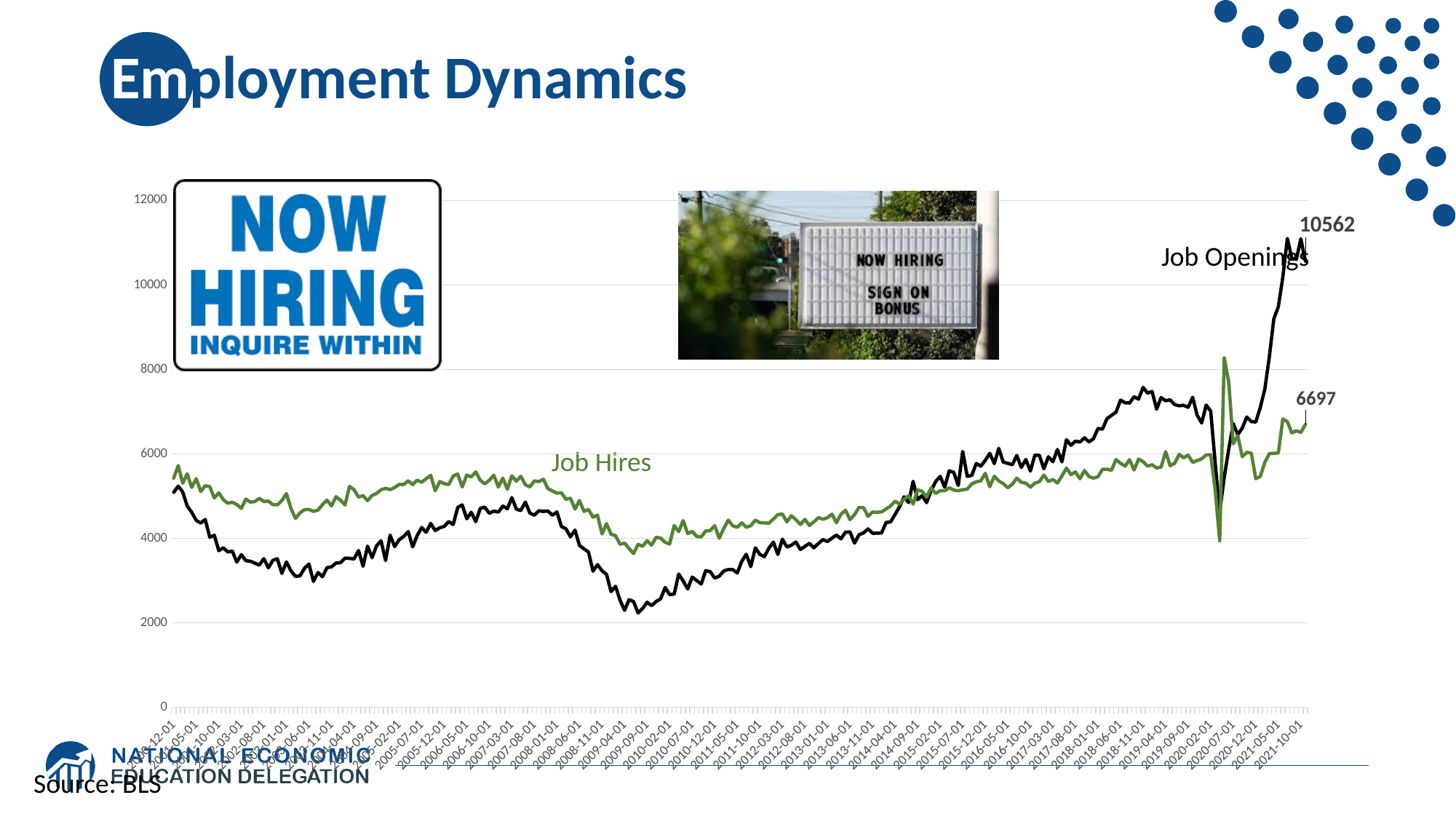
Is the value for Job Hires at 2000-12-01 greater or less than 4000? greater At the end of the chart, which series is larger, Job Openings or Job Hires? Job Openings How many series are plotted on the chart? 2 Does the Job Openings series generally rise or fall between 2009-09-01 and 2018-11-01? Rise What is the final labelled value of the Job Openings series? 10562 Which series reaches the highest value anywhere on the chart? Job Openings Is the value for Job Openings around 2009-09-01 greater or less than 4000? less What is the difference between the final labelled values of Job Openings and Job Hires? 3865 Is the value for Job Openings at 2000-12-01 greater or less than 6000? less What source is cited for the chart data? BLS What is the final labelled value of the Job Hires series? 6697 What kind of chart is shown on the slide? Line chart